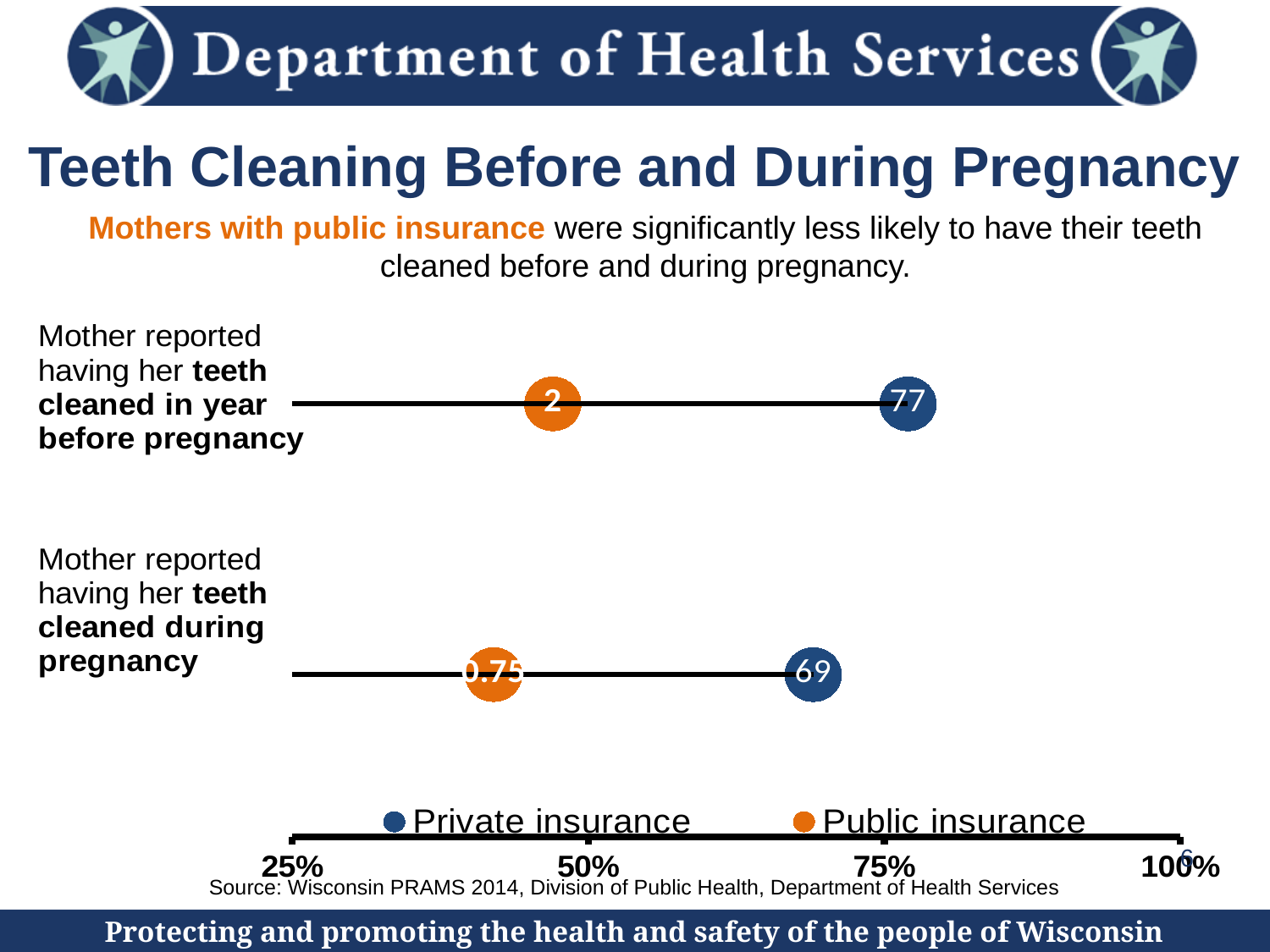
Which colour represents public insurance in the chart? Orange For teeth cleaned in the year before pregnancy, which insurance group has the higher value? Private insurance How many series does the legend list? 2 What percentage of mothers with private insurance reported having their teeth cleaned in the year before pregnancy? 77 Is the value for public insurance mothers who had their teeth cleaned during pregnancy greater or less than 50%? less For teeth cleaned during pregnancy, which insurance group has the lower value? Public insurance Is the value for public insurance mothers who had their teeth cleaned in the year before pregnancy greater or less than 25%? greater Is the value for private insurance mothers who had their teeth cleaned in the year before pregnancy greater or less than 75%? greater What percentage of mothers with private insurance reported having their teeth cleaned during pregnancy? 69 How many categories are plotted on the chart? 2 For private insurance, which is larger: teeth cleaned in the year before pregnancy or teeth cleaned during pregnancy? Teeth cleaned in year before pregnancy For private insurance, what is the difference between the value for teeth cleaned in the year before pregnancy and teeth cleaned during pregnancy? 8